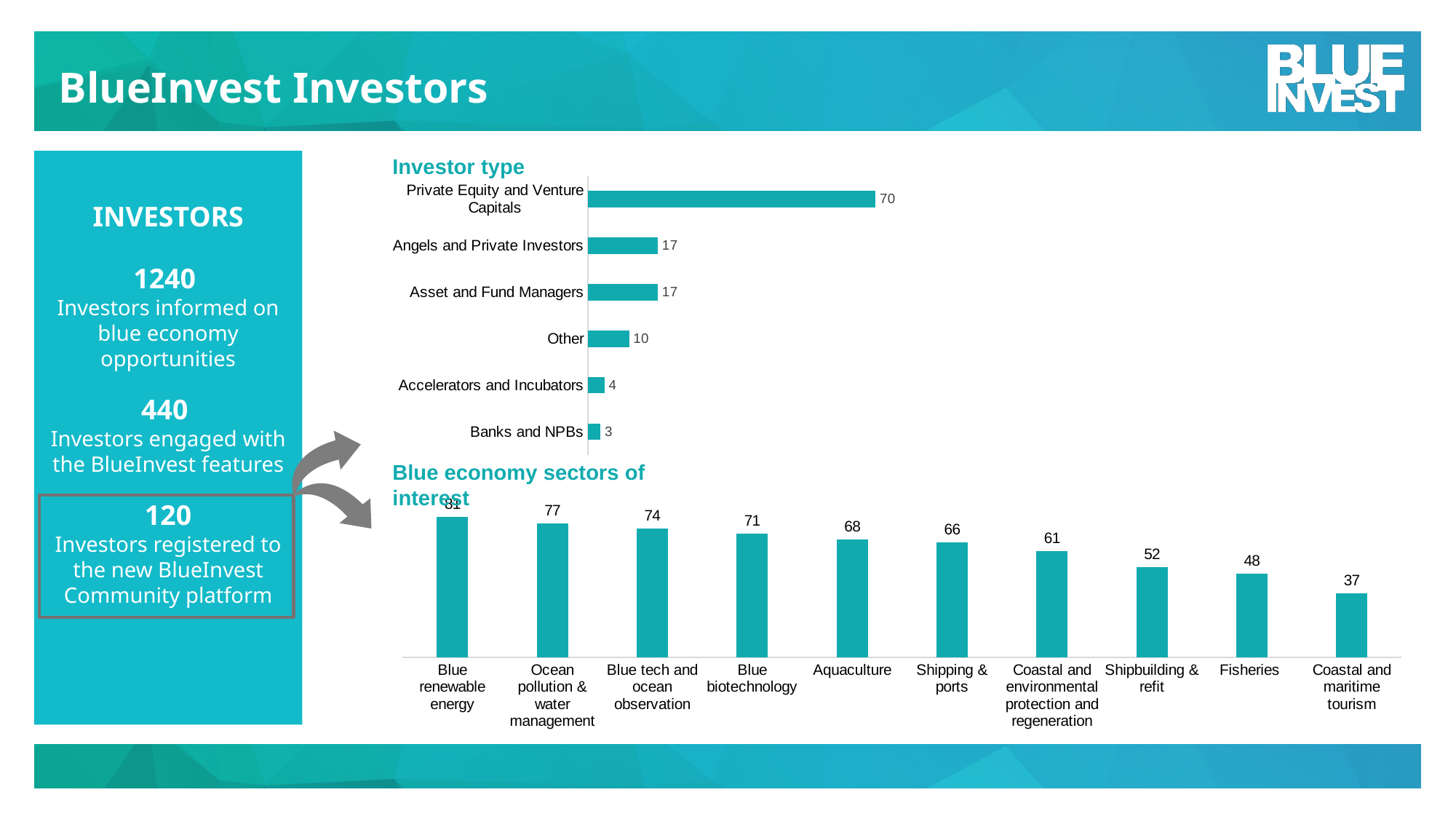
In the Investor type chart, which investor type has the lowest value? Banks and NPBs In the Blue economy sectors of interest chart, which sector has the highest value? Blue renewable energy In the Investor type chart, what is the value for Other? 10 In the Investor type chart, what is the value for Private Equity and Venture Capitals? 70 In the Blue economy sectors of interest chart, which is larger: Shipbuilding & refit or Fisheries? Shipbuilding & refit In the Blue economy sectors of interest chart, what is the difference between Ocean pollution & water management and Blue biotechnology? 6 In the Blue economy sectors of interest chart, how many sectors are shown? 10 In the Investor type chart, what is the difference between Private Equity and Venture Capitals and Angels and Private Investors? 53 In the Investor type chart, how many investor types are shown? 6 In the Blue economy sectors of interest chart, what is the value for Coastal and maritime tourism? 37 In the Blue economy sectors of interest chart, what is the value for Aquaculture? 68 What kind of chart is the Investor type chart? Bar chart